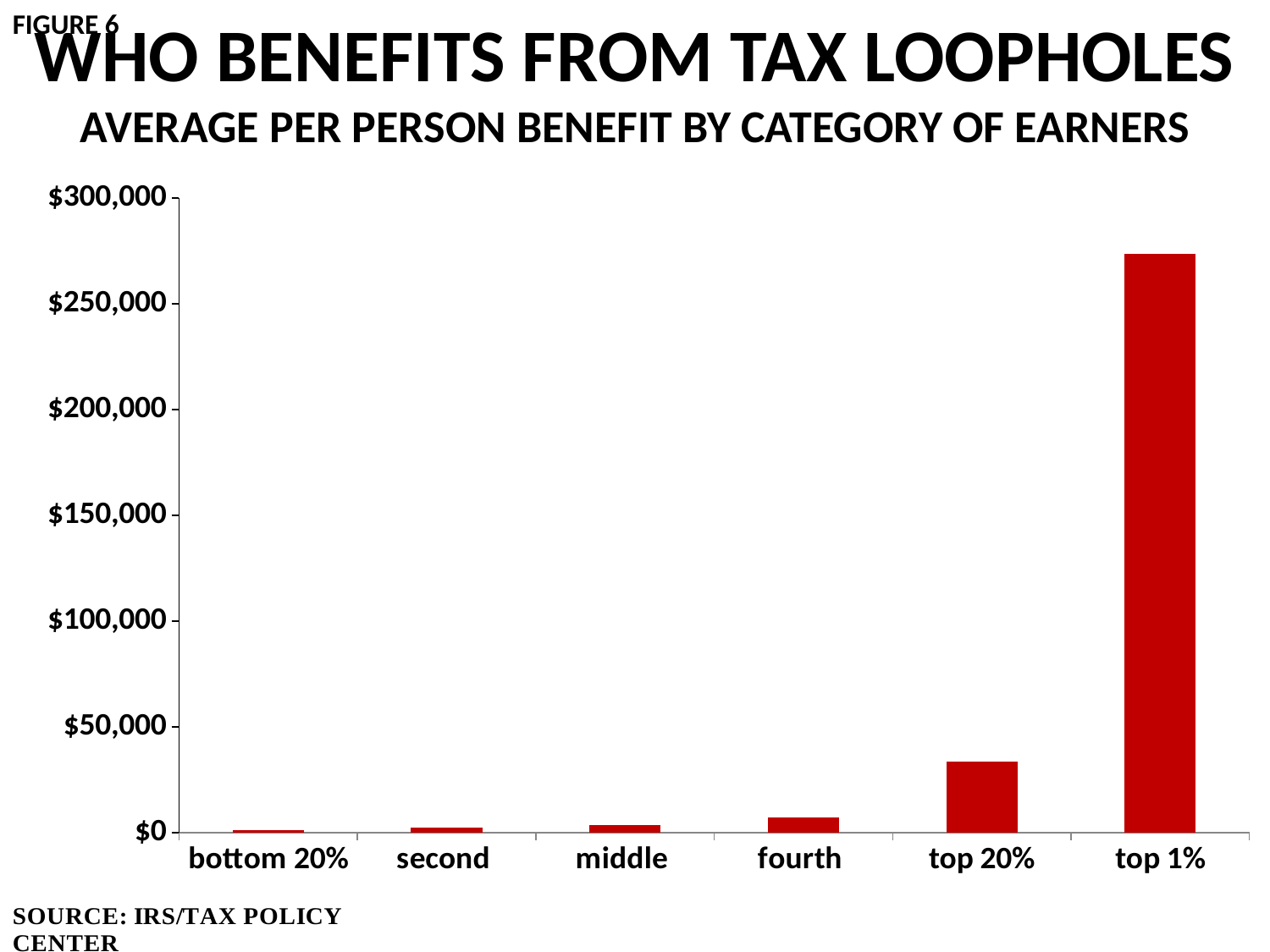
What kind of chart is shown on the slide? bar chart Which is larger, the value for middle or the value for top 1%? top 1% Which category has the highest average per person benefit? top 1% Do the values rise or fall moving from bottom 20% to top 1% along the x axis? rise Is the value for top 20% greater or less than $50,000? less What source is cited for the chart? IRS/TAX POLICY CENTER What is the subtitle of the chart? AVERAGE PER PERSON BENEFIT BY CATEGORY OF EARNERS Which is larger, the value for top 20% or the value for fourth? top 20% Is the value for top 1% greater or less than $250,000? greater How many categories of earners are shown on the x axis? 6 Which category has the lowest average per person benefit? bottom 20% Is the value for fourth greater or less than $50,000? less